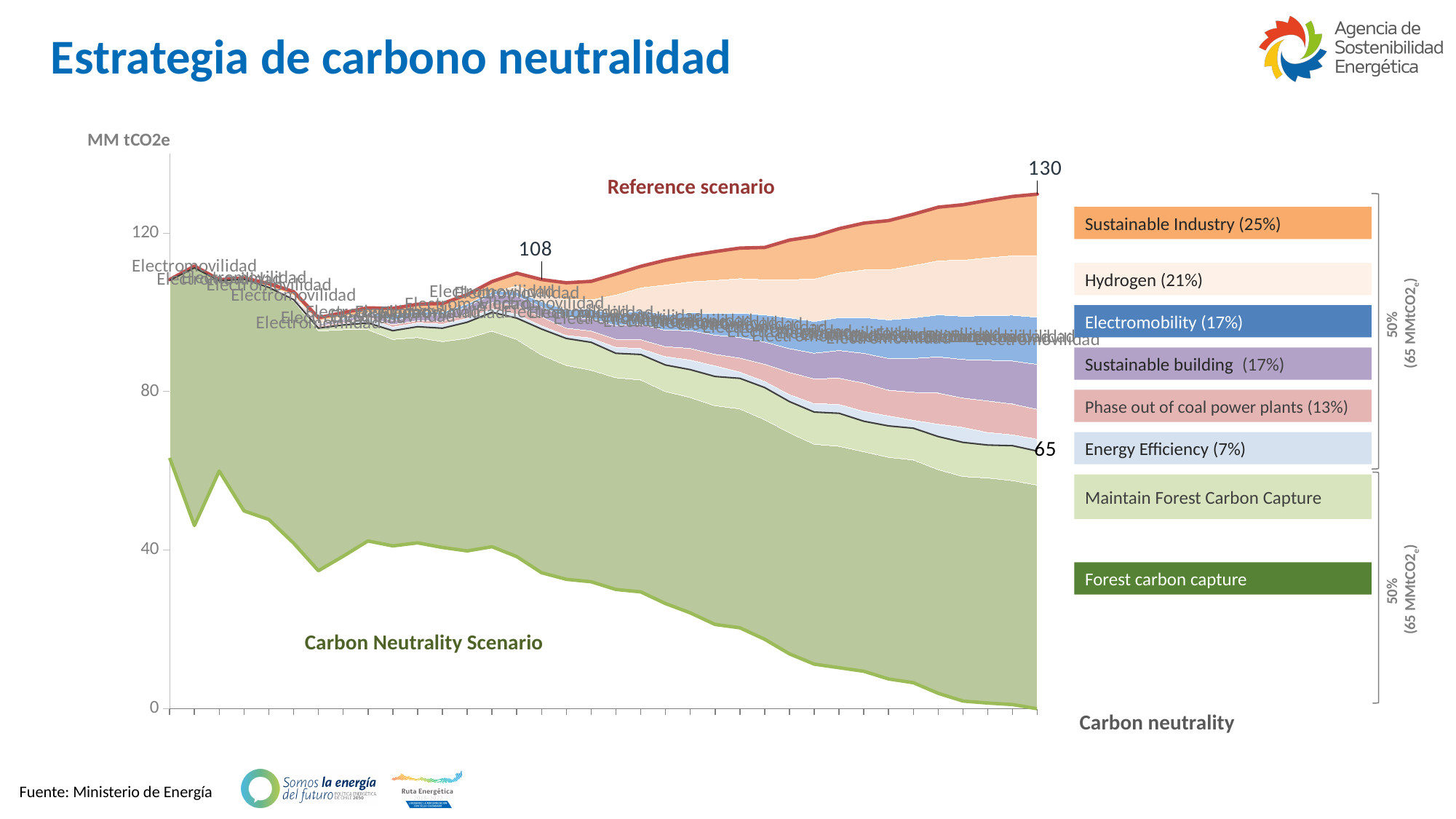
What value is labelled at the right end of the Carbon Neutrality Scenario line (above the forest capture area)? 65 What value does the Reference scenario reach at the right end of the chart? 130 What is the difference between the Reference scenario's final value (130) and the Carbon Neutrality Scenario's final value (65)? 65 What value is labelled at the peak of the Reference scenario line near the middle of the chart? 108 Which has the larger share, Sustainable Industry or Energy Efficiency? Sustainable Industry What share does Sustainable Industry contribute according to the legend? 25% What share does Phase out of coal power plants contribute according to the legend? 13% What share does Energy Efficiency contribute according to the legend? 7% Is the final value of the Reference scenario greater or less than 120? greater What unit is shown on the vertical axis of the chart? MM tCO2e What kind of chart is shown on the slide? Area chart